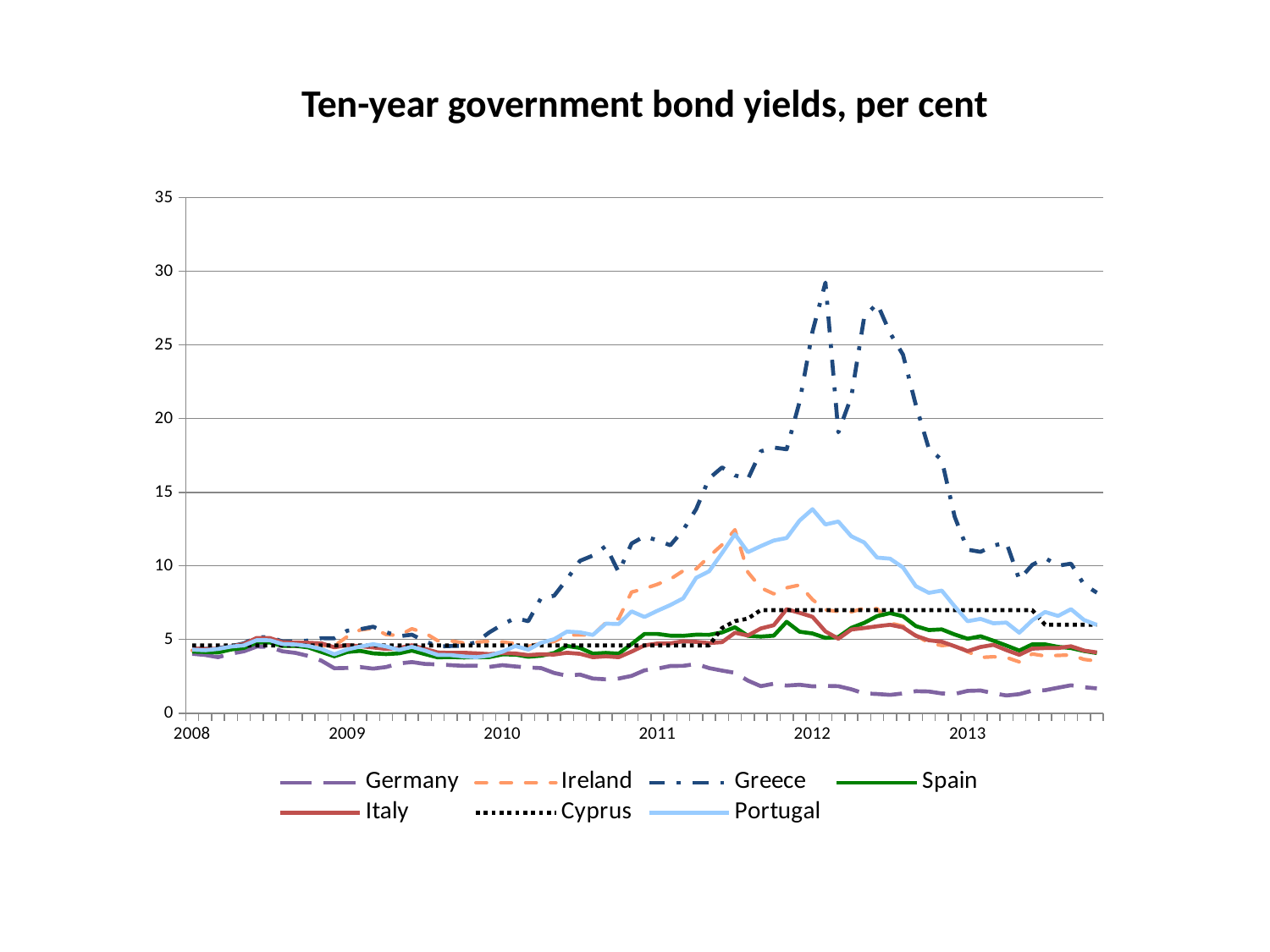
What kind of chart is shown on the slide? line chart Does the Germany series generally rise or fall from 2008 to 2013? fall Which series has the lowest values at the end of the period in 2013? Germany Which series reaches the highest value on the chart? Greece Is the peak value for Ireland greater or less than 10? greater How many year labels are shown on the x axis? 6 How many series does the legend list? 7 Is the peak value for Portugal greater or less than 10? greater What is the title of the chart? Ten-year government bond yields, per cent Is the value for Germany at the end of 2013 greater or less than 5? less Which series is larger at the start of 2012, Greece or Portugal? Greece